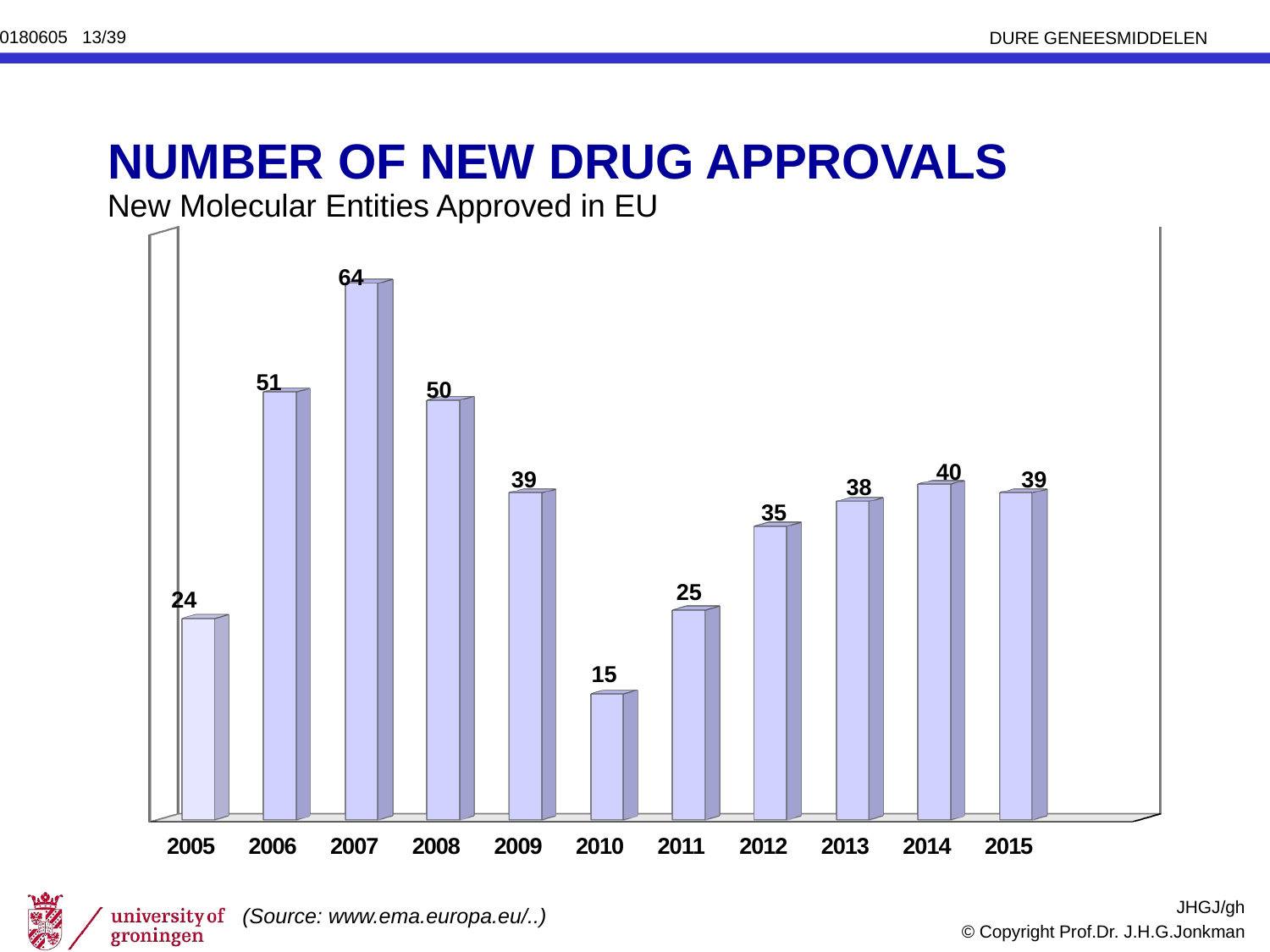
Which year has the highest number of new drug approvals? 2007 Which year has the lowest number of new drug approvals? 2010 What is the difference between the number of approvals in 2006 and 2008? 1 What is the number of new drug approvals in 2013? 38 What is the number of new drug approvals in 2007? 64 Do the values rise or fall from 2010 to 2014? Rise What is the difference between the number of approvals in 2007 and 2010? 49 What is the number of new drug approvals in 2010? 15 Which year had more new drug approvals, 2005 or 2011? 2011 How many years are shown on the x axis of the chart? 11 What is the subtitle of the chart? New Molecular Entities Approved in EU What kind of chart is shown on the slide? Bar chart